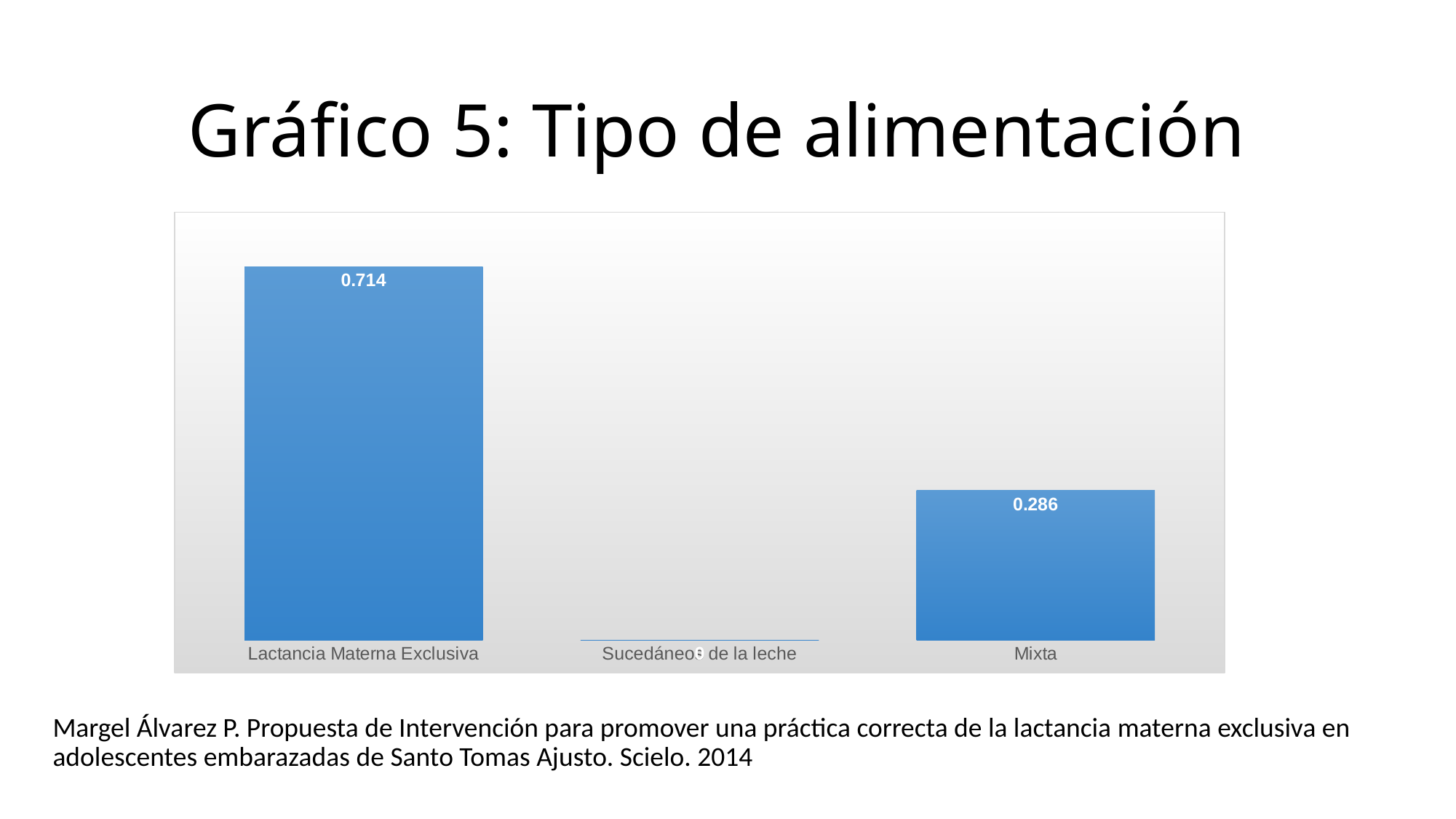
What kind of chart is shown on the slide? Bar chart What is the title of the slide? Gráfico 5: Tipo de alimentación Which category has the highest value? Lactancia Materna Exclusiva What is the value for Lactancia Materna Exclusiva? 0.714 How many categories are shown on the x axis? 3 What is the value for Mixta? 0.286 Which category has the lowest value? Sucedáneos de la leche What colour are the bars in the chart? Blue What is the value for Sucedáneos de la leche? 0 Which is larger, the value for Mixta or the value for Lactancia Materna Exclusiva? Lactancia Materna Exclusiva What is the difference between the values for Lactancia Materna Exclusiva and Mixta? 0.428